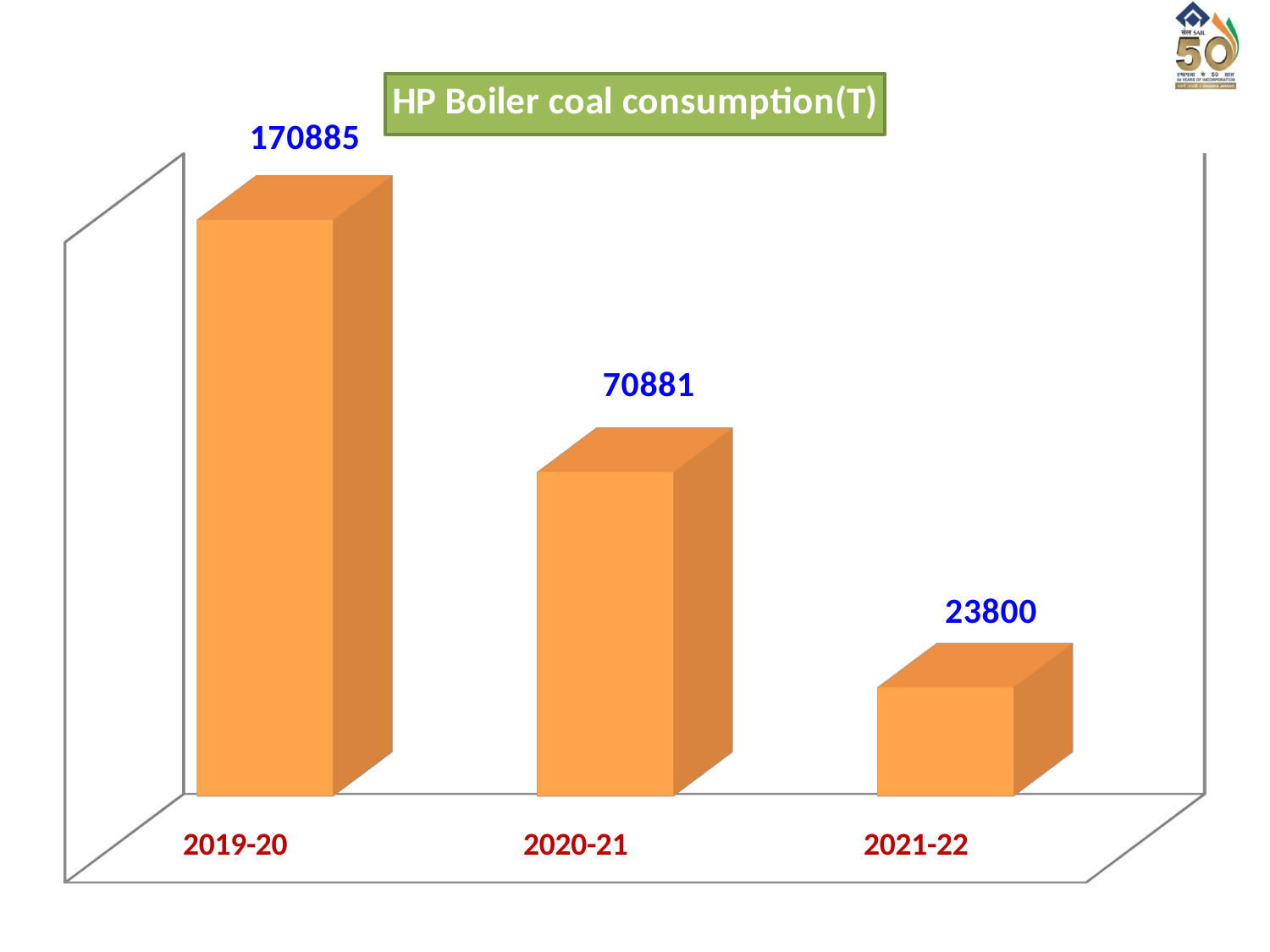
How many years are shown on the chart? 3 What is the HP Boiler coal consumption for 2021-22? 23800 Which year has the highest HP Boiler coal consumption? 2019-20 Do the values rise or fall from 2019-20 to 2021-22? Fall Which is larger, the coal consumption in 2020-21 or in 2021-22? 2020-21 What is the HP Boiler coal consumption for 2020-21? 70881 What kind of chart is shown on the slide? Bar chart What is the HP Boiler coal consumption for 2019-20? 170885 What is the difference in HP Boiler coal consumption between 2020-21 and 2021-22? 47081 What is the difference in HP Boiler coal consumption between 2019-20 and 2020-21? 100004 Which year has the lowest HP Boiler coal consumption? 2021-22 What is the title of the chart? HP Boiler coal consumption(T)